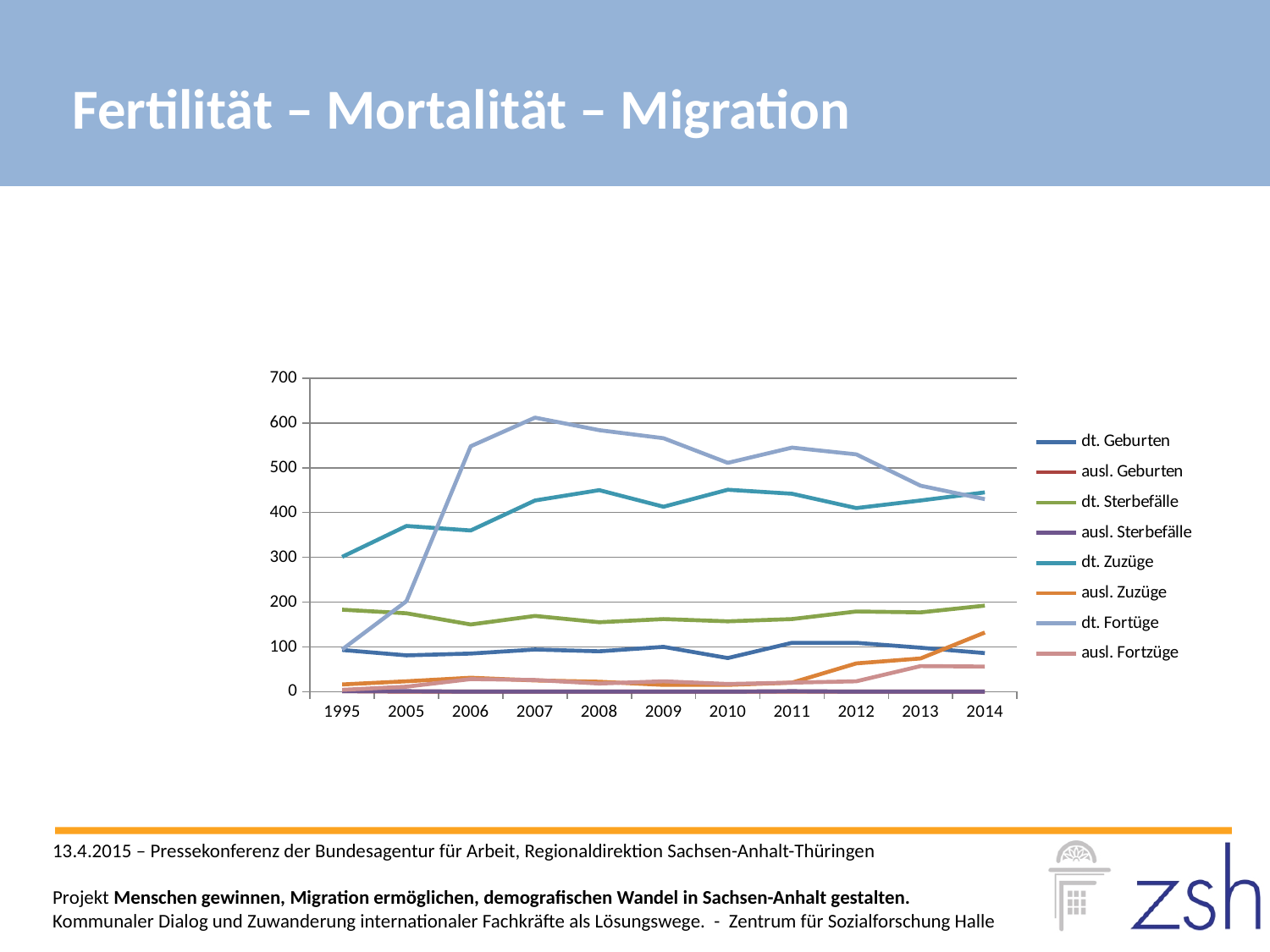
Is the value for ausl. Zuzüge in 2014 greater or less than 100? greater In which year does dt. Fortzüge reach its highest value? 2007 In 2012, which is larger: dt. Fortzüge or dt. Zuzüge? dt. Fortzüge What kind of chart is shown on the slide? line chart In 1995, which is larger: dt. Geburten or dt. Sterbefälle? dt. Sterbefälle What colour is the dt. Sterbefälle line in the legend? green Does the ausl. Zuzüge line rise or fall from 2011 to 2014? rise How many series does the legend list? 8 Is the value for dt. Sterbefälle in 2014 greater or less than 100? greater How many years are shown on the x axis? 11 Is the value for dt. Fortzüge in 2007 greater or less than 500? greater